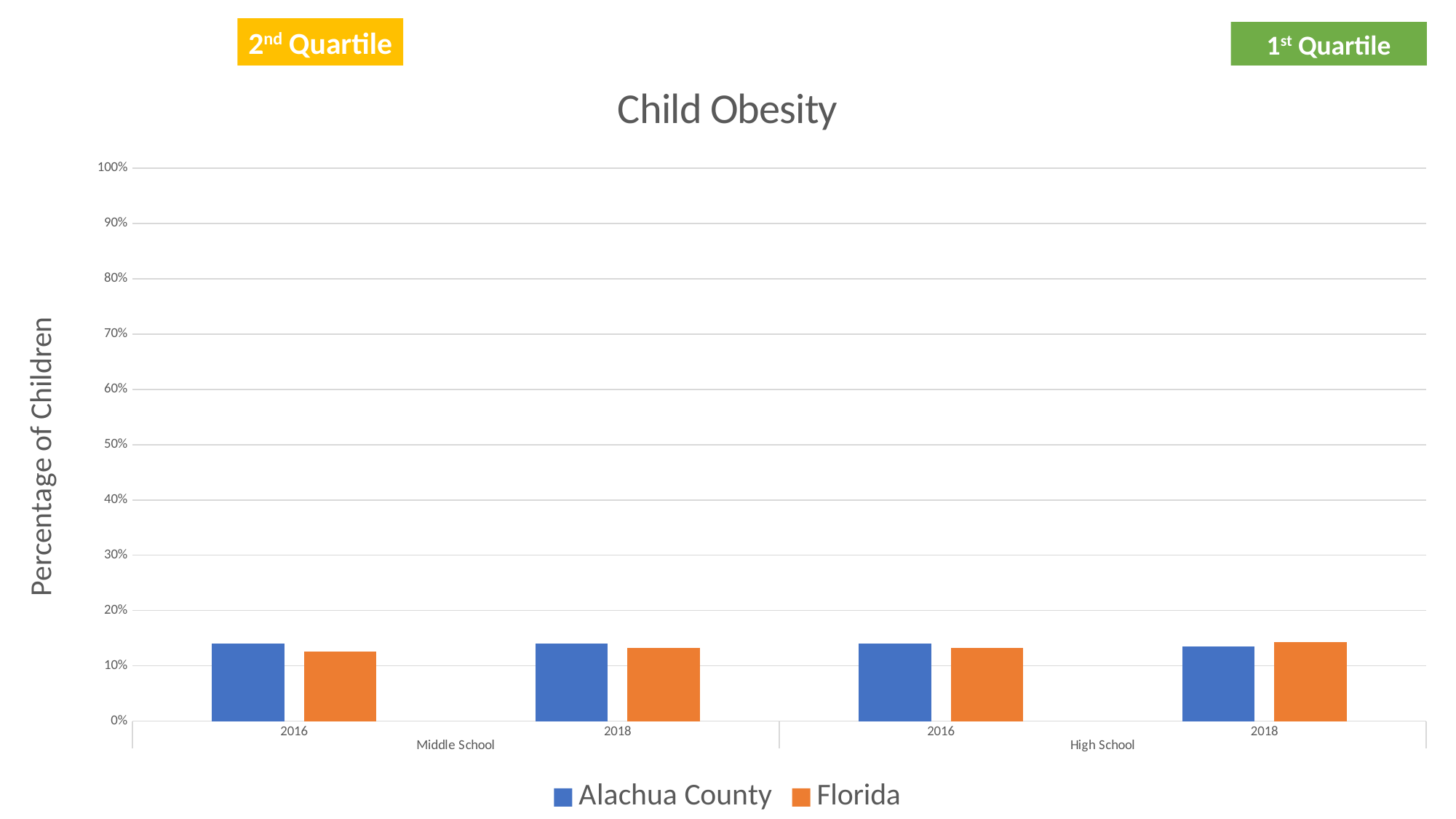
In Middle School 2016, which is larger, Alachua County or Florida? Alachua County Is the value for Florida in High School 2018 greater or less than 20%? less What is the title of the chart? Child Obesity Which two series are listed in the chart legend? Alachua County and Florida In High School 2018, which is larger, Alachua County or Florida? Florida Is the value for Alachua County in Middle School 2016 greater or less than 20%? less How many year categories are plotted along the x axis? 4 How many series does the legend list? 2 Is the value for Florida in Middle School 2018 greater or less than 30%? less What type of chart is shown on the slide? bar chart